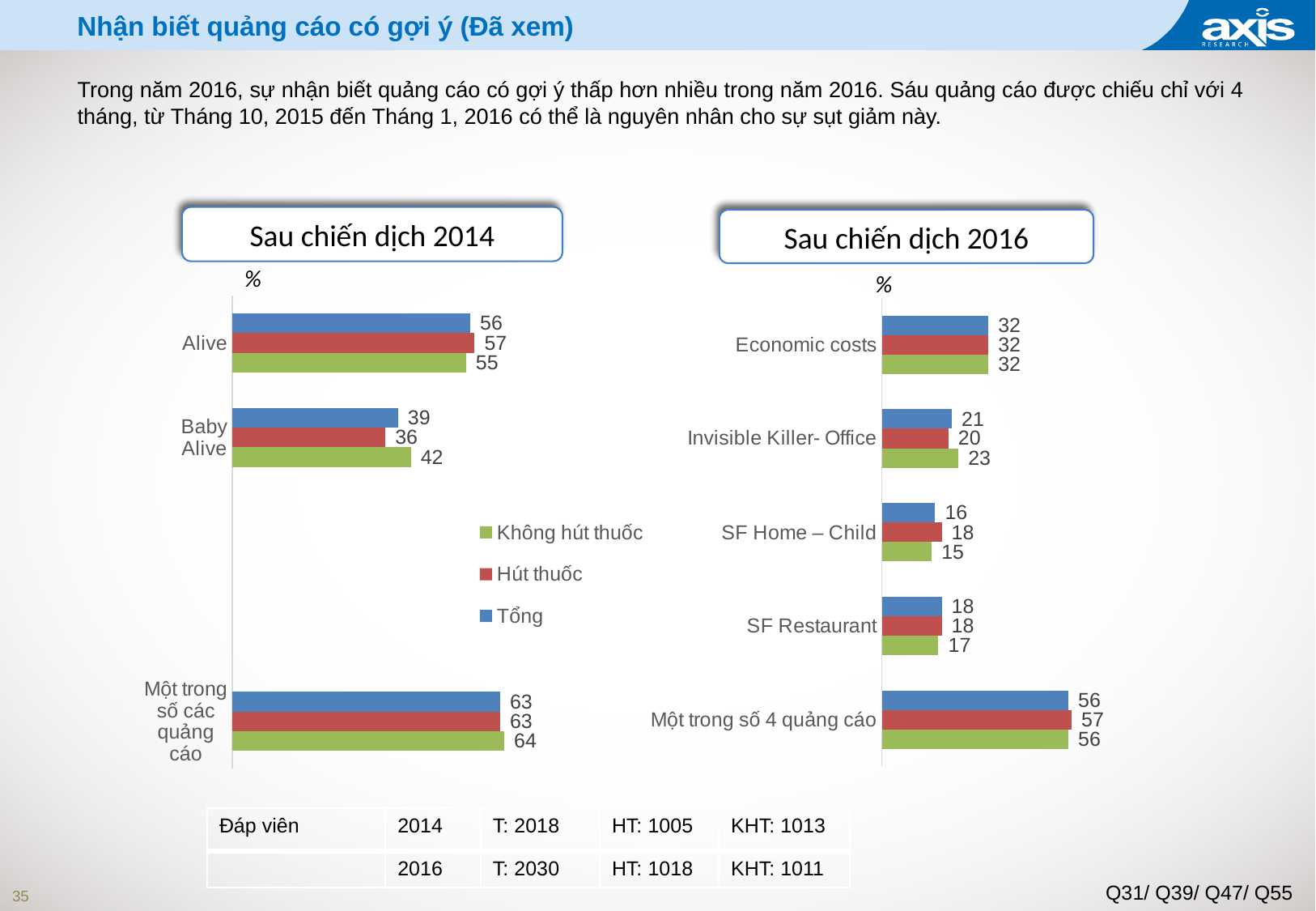
In the 'Sau chiến dịch 2014' chart, what is the Tổng value for Alive? 56 What type of chart is the 'Sau chiến dịch 2014' chart? Bar chart In the 'Sau chiến dịch 2014' chart, what is the difference between the Tổng values for Alive and Baby Alive? 17 In the 'Sau chiến dịch 2016' chart, which category has the highest Tổng value? Một trong số 4 quảng cáo In the 'Sau chiến dịch 2014' chart, which is larger for Baby Alive: the Hút thuốc value or the Không hút thuốc value? Không hút thuốc In the 'Sau chiến dịch 2016' chart, which category has the lowest Không hút thuốc value? SF Home – Child In the 'Sau chiến dịch 2016' chart, what is the difference between the Tổng values for Economic costs and SF Restaurant? 14 In the 'Sau chiến dịch 2014' chart, what is the Không hút thuốc value for Baby Alive? 42 How many categories are shown in the 'Sau chiến dịch 2016' chart? 5 How many series does the legend list? 3 In the 'Sau chiến dịch 2016' chart, what is the Không hút thuốc value for Invisible Killer- Office? 23 In the 'Sau chiến dịch 2016' chart, what is the Hút thuốc value for SF Home – Child? 18